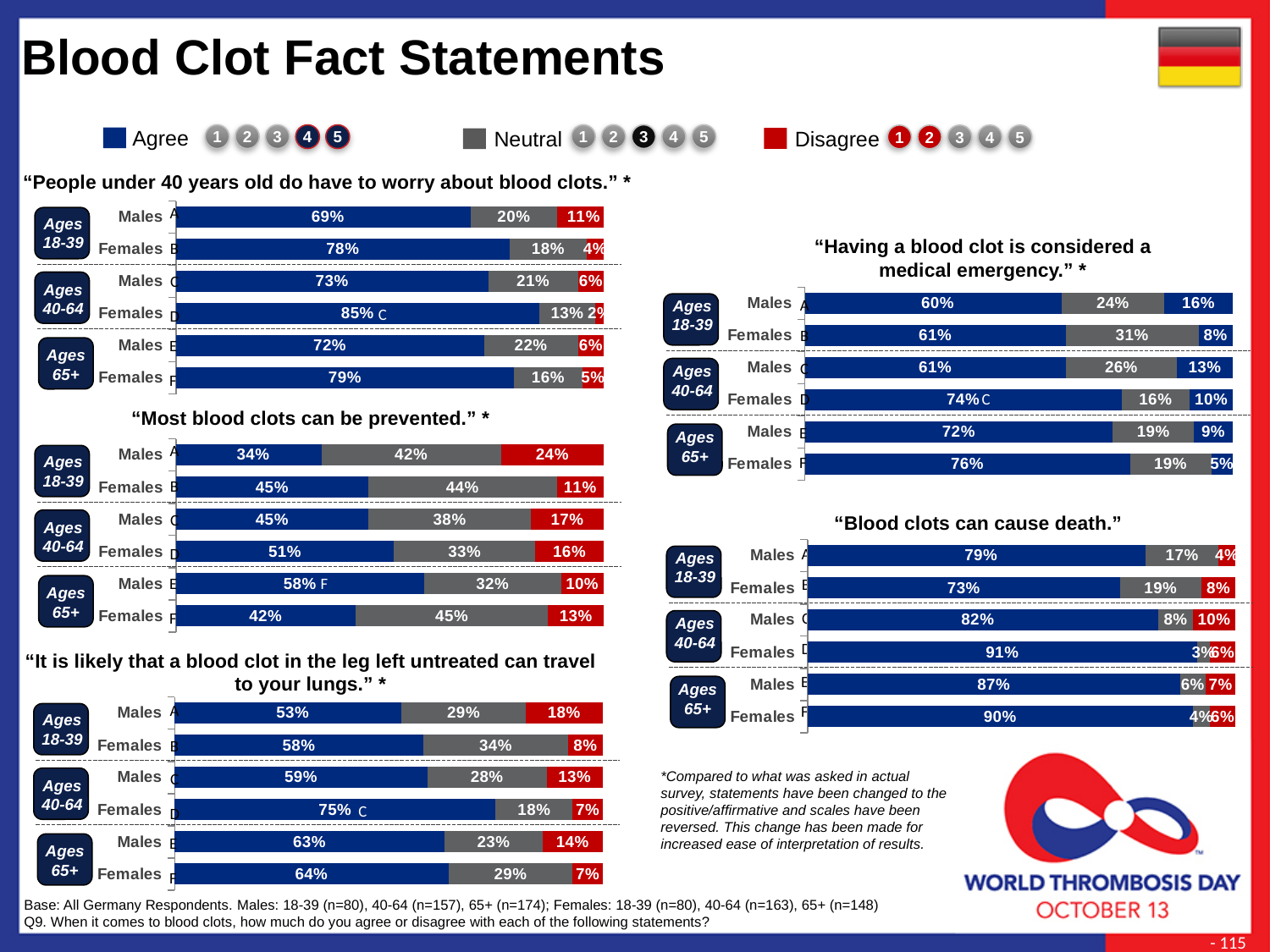
In the chart "It is likely that a blood clot in the leg left untreated can travel to your lungs.", which is larger: the Agree percentage for Males 65+ or for Males 40-64? Males 65+ How many series does the legend at the top of the slide list? 3 In the chart "People under 40 years old do have to worry about blood clots.", what percentage of Females aged 40-64 agree? 85% In the chart "People under 40 years old do have to worry about blood clots.", which group has the highest Agree percentage? Females 40-64 In the chart "Blood clots can cause death.", what percentage of Females aged 40-64 agree? 91% How many groups (bars) are shown in the chart "Blood clots can cause death."? 6 In the chart "It is likely that a blood clot in the leg left untreated can travel to your lungs.", what percentage of Females aged 18-39 are neutral? 34% In the chart "Having a blood clot is considered a medical emergency.", which group has the highest Disagree percentage? Males 18-39 In the chart "Most blood clots can be prevented.", what is the difference between the Agree percentages for Males 65+ and Females 65+? 16% In the chart "Most blood clots can be prevented.", which group has the lowest Agree percentage? Males 18-39 In the chart "Having a blood clot is considered a medical emergency.", what percentage of Females aged 18-39 are neutral? 31% In the chart "Most blood clots can be prevented.", what percentage of Males aged 18-39 disagree? 24%